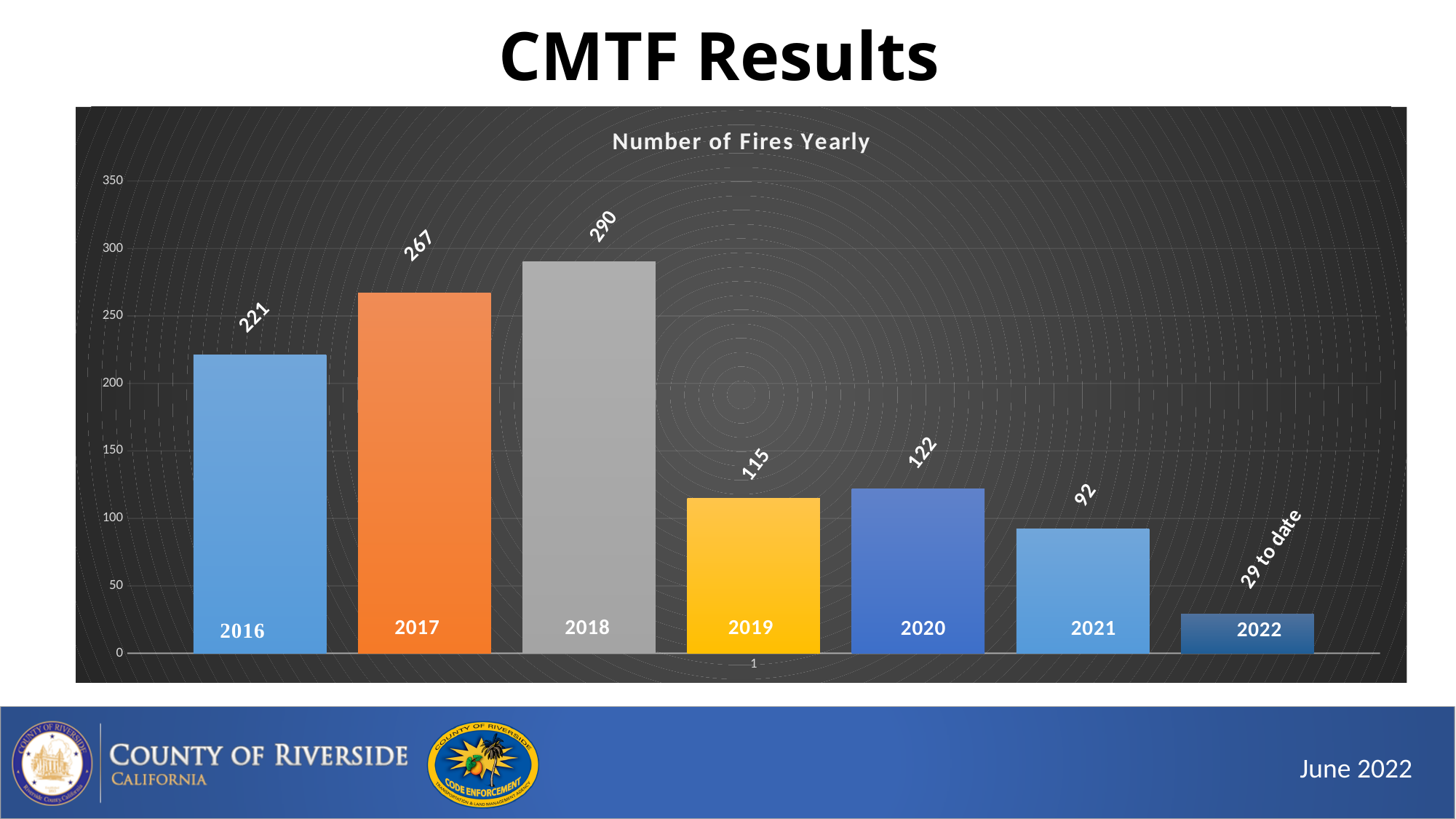
What is the difference in the number of fires between 2017 and 2016? 46 Which year has the highest number of fires? 2018 Which year has the lowest number of fires? 2022 How many years are shown on the chart? 7 What is the title of the chart? Number of Fires Yearly What is the number of fires for 2018? 290 What is the difference in the number of fires between 2020 and 2019? 7 What kind of chart is shown on the slide? Bar chart What is the number of fires for 2016? 221 Is the value for 2017 greater or less than 250? greater What is the data label shown for 2022? 29 to date Which year had more fires, 2019 or 2021? 2019